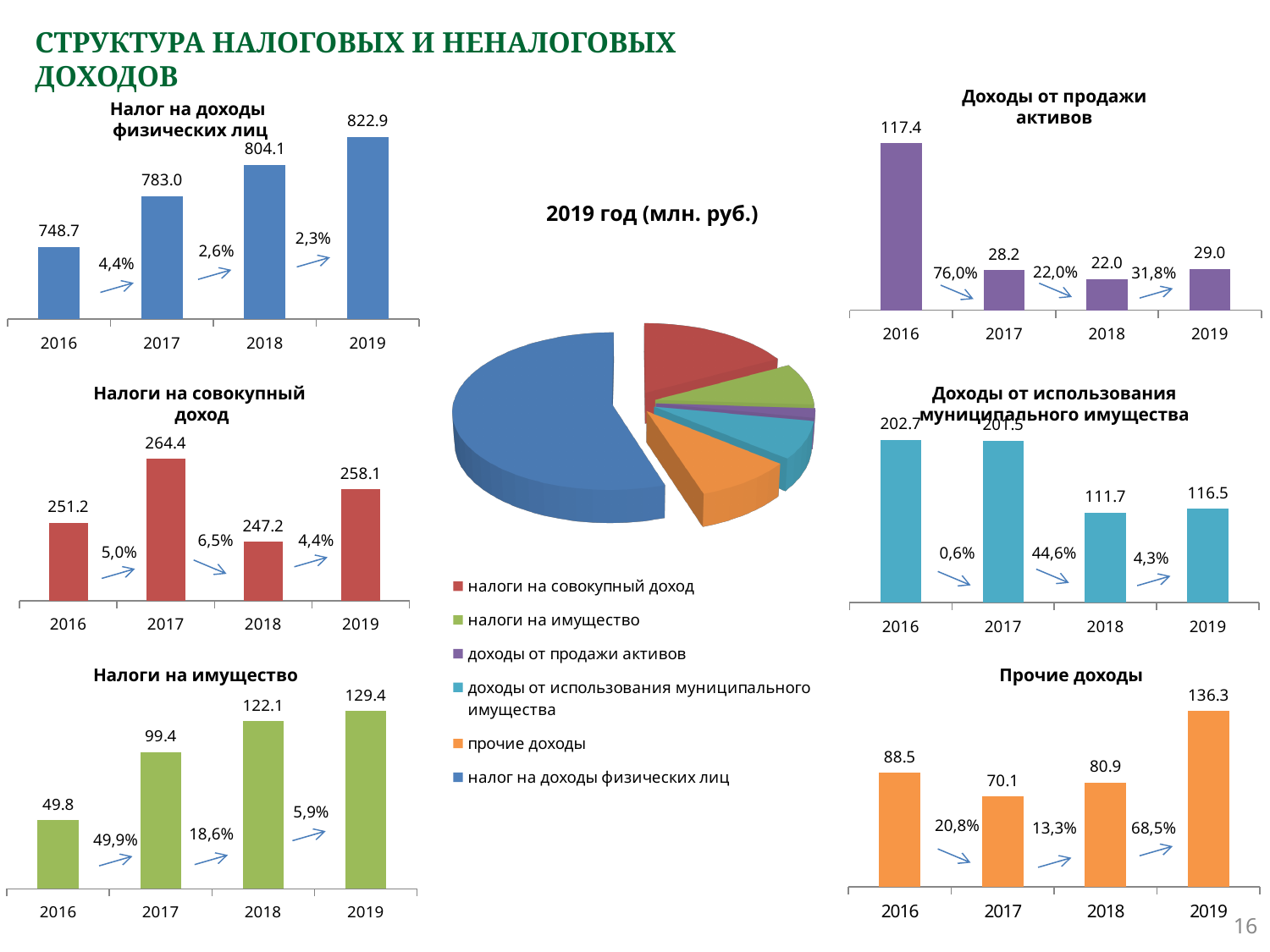
In the chart titled "Доходы от продажи активов", which is larger, the value for 2016 or the value for 2017? 2016 How many categories does the legend of the pie chart titled "2019 год (млн. руб.)" list? 6 In the chart titled "Налоги на имущество", what is the value for 2016? 49.8 In the chart titled "Прочие доходы", what is the difference between the 2019 value and the 2018 value? 55.4 What kind of chart is the chart titled "Прочие доходы"? bar chart In the chart titled "Доходы от продажи активов", what is the value for 2018? 22.0 In the chart titled "Налог на доходы физических лиц", do the values rise or fall from 2016 to 2019? rise In the chart titled "Налог на доходы физических лиц", what is the value for 2019? 822.9 In the chart titled "Доходы от использования муниципального имущества", what is the value for 2018? 111.7 In the chart titled "Налоги на совокупный доход", which year has the highest value? 2017 In the chart titled "Налоги на совокупный доход", what is the difference between the 2017 value and the 2018 value? 17.2 In the chart titled "Налоги на имущество", which year has the lowest value? 2016